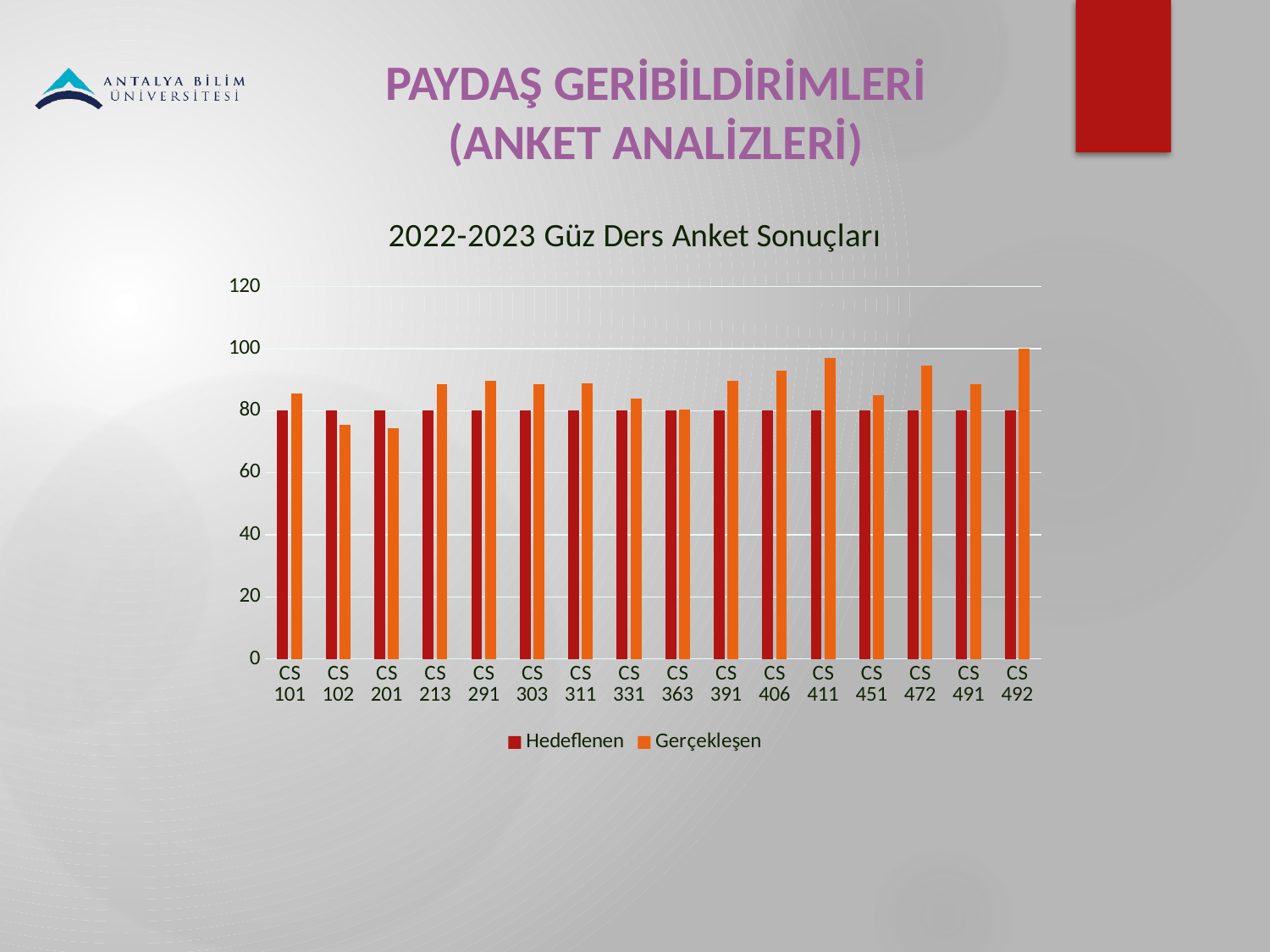
What is the Hedeflenen value for CS 101? 80 What is the Hedeflenen value for CS 492? 80 Is the Gerçekleşen value for CS 411 greater or less than 80? greater How many courses (categories) are shown on the x axis? 16 What is the title of the chart? 2022-2023 Güz Ders Anket Sonuçları What type of chart is shown on the slide? bar chart Which series is shown in orange in the legend? Gerçekleşen Which is larger, the Gerçekleşen value for CS 411 or for CS 101? CS 411 Is the Gerçekleşen value for CS 201 greater or less than 80? less Which course has the highest Gerçekleşen value? CS 492 How many series does the legend list? 2 Is the Gerçekleşen value for CS 102 greater or less than 80? less